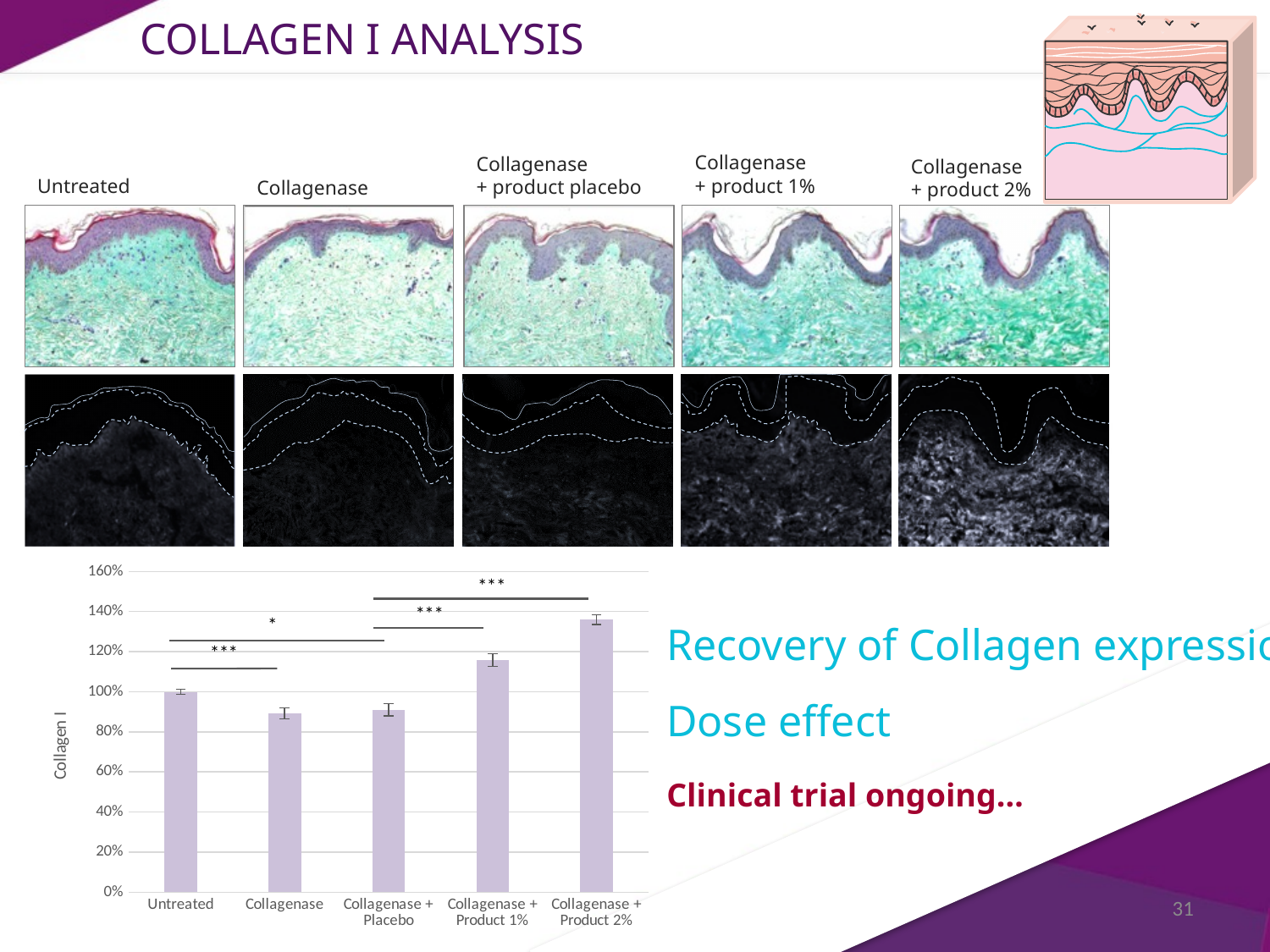
Which category has the highest value in the bar chart? Collagenase + Product 2% How many categories are plotted on the x axis of the bar chart? 5 Which is larger, the value for Collagenase + Product 2% or the value for Untreated? Collagenase + Product 2% Is the value for Collagenase greater or less than 100%? less Do the values rise or fall from Collagenase + Placebo to Collagenase + Product 2% along the x axis? rise What kind of chart is shown at the bottom left of the slide? bar chart Is the value for Collagenase + Product 2% greater or less than 120%? greater Which is larger, the value for Collagenase or the value for Collagenase + Product 1%? Collagenase + Product 1% Is the value for Collagenase + Placebo greater or less than 100%? less What is the label on the y axis of the bar chart? Collagen I What is the value for Untreated in the bar chart? 100%